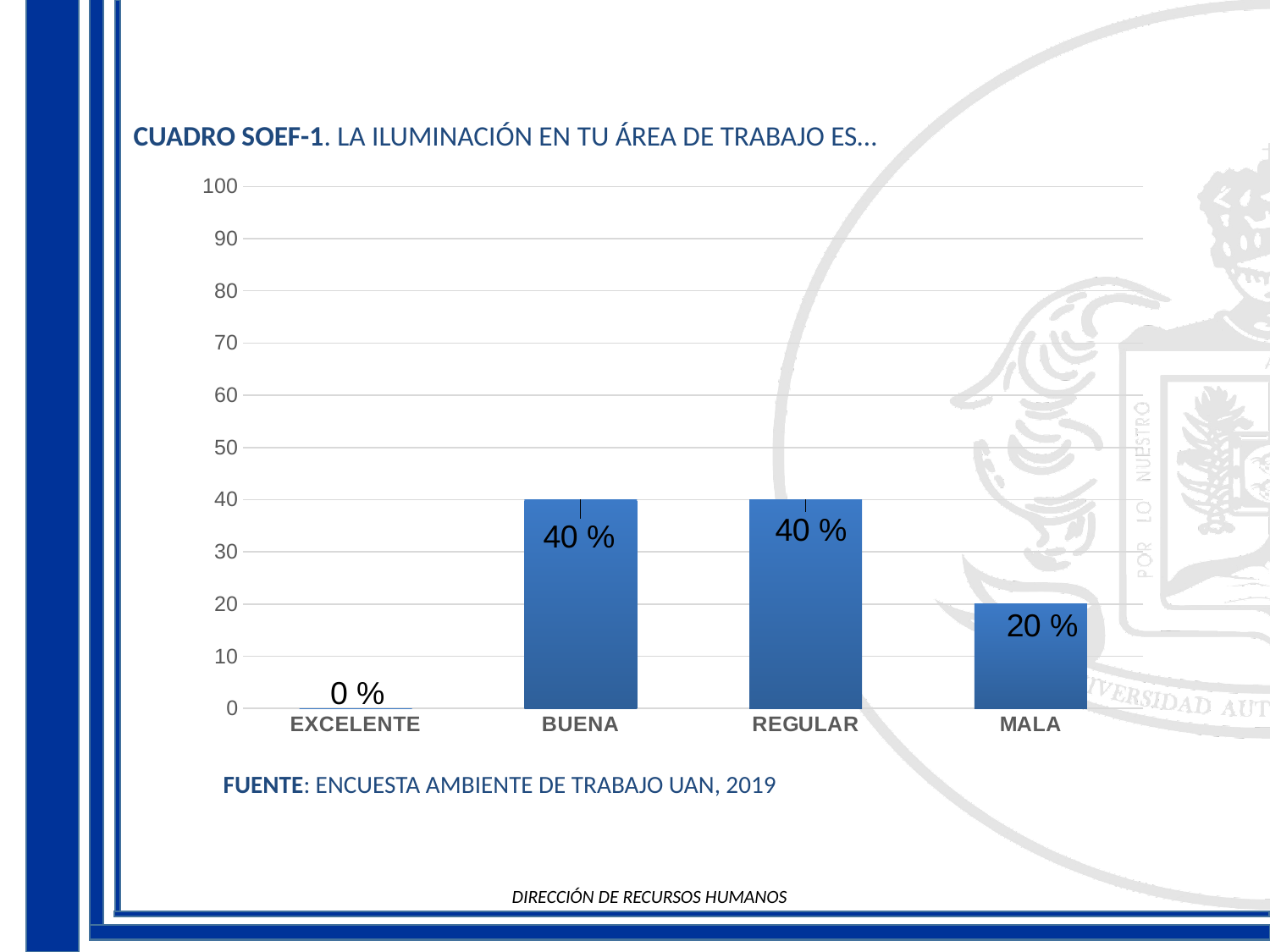
What is the maximum value shown on the y axis? 100 What is the value for MALA? 20 % Is the value for MALA greater or less than 30? less What is the source cited below the chart? ENCUESTA AMBIENTE DE TRABAJO UAN, 2019 What is the difference between the values for BUENA and MALA? 20 % Which category has the lowest value? EXCELENTE What is the value for REGULAR? 40 % What is the value for EXCELENTE? 0 % What is the value for BUENA? 40 % How many categories are shown on the x axis? 4 What kind of chart is shown on the slide? bar chart Which is larger, the value for REGULAR or the value for MALA? REGULAR